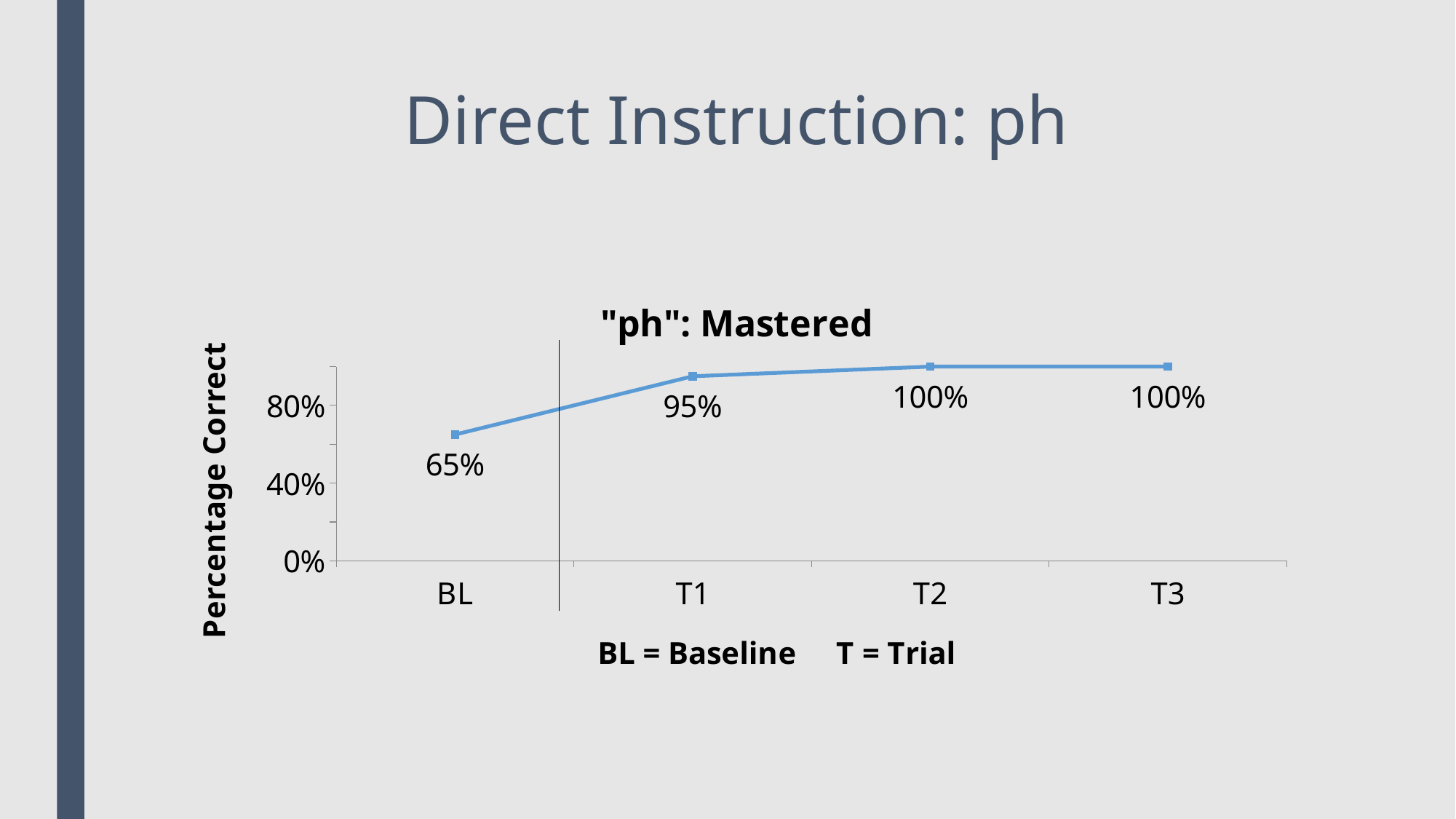
What is the difference in percentage correct between T1 and BL? 30% What is the percentage correct at BL? 65% What is the percentage correct at T1? 95% What kind of chart is shown on the slide? line chart What is the difference in percentage correct between T2 and T1? 5% Which point has the lowest percentage correct? BL What is the percentage correct at T3? 100% How many points are plotted on the chart? 4 Do the values rise or fall from BL to T3? rise Is the value for BL greater or less than 80%? less What is the percentage correct at T2? 100% Which has a higher percentage correct, BL or T1? T1